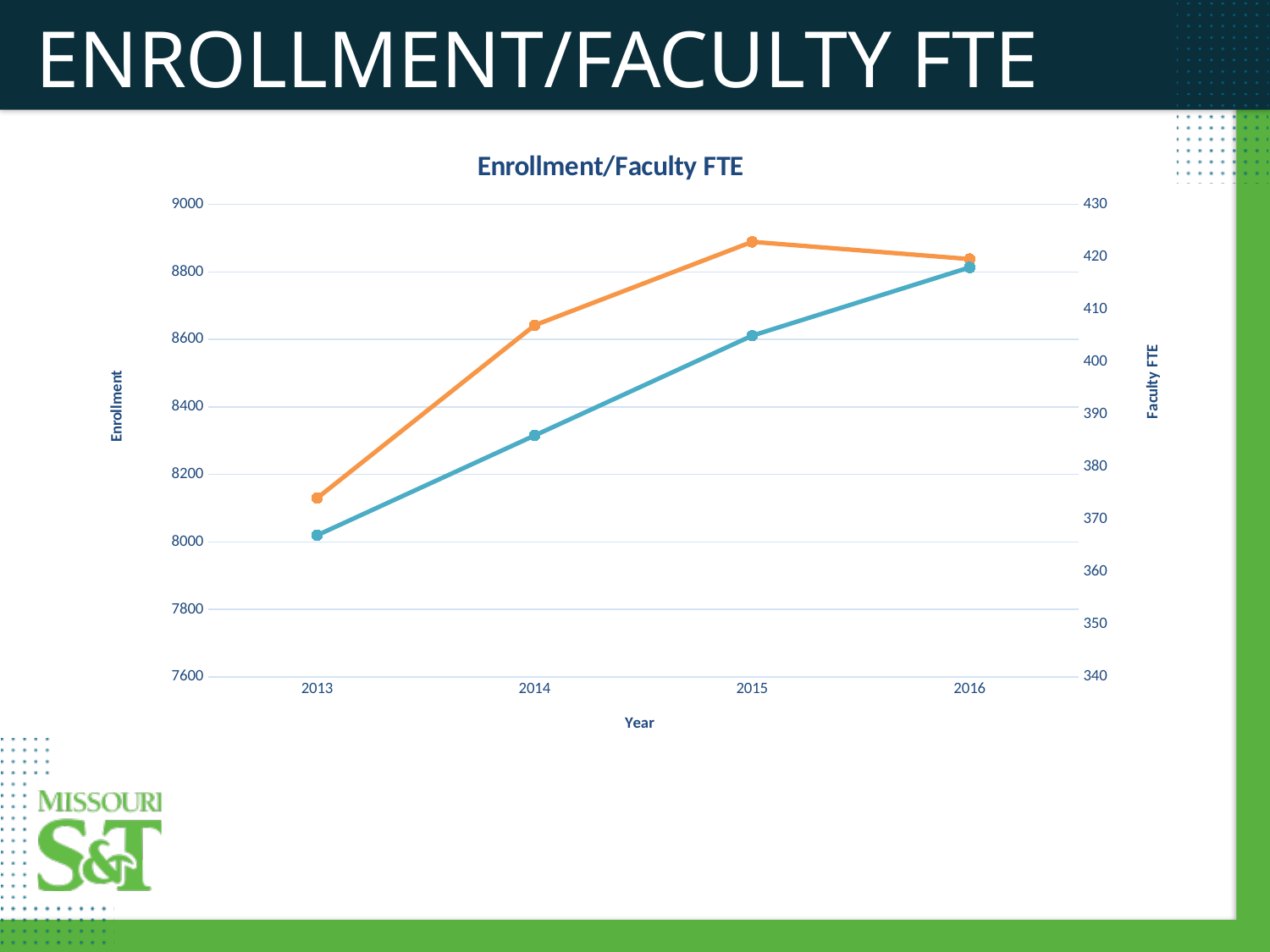
What is the label of the x axis? Year What is the title of the chart? Enrollment/Faculty FTE In which year is the blue line at its highest? 2016 What kind of chart is shown on the slide? line chart How many years are plotted along the x axis? 4 Does the blue line rise or fall from 2013 to 2016? rise In which year is the blue line at its lowest? 2013